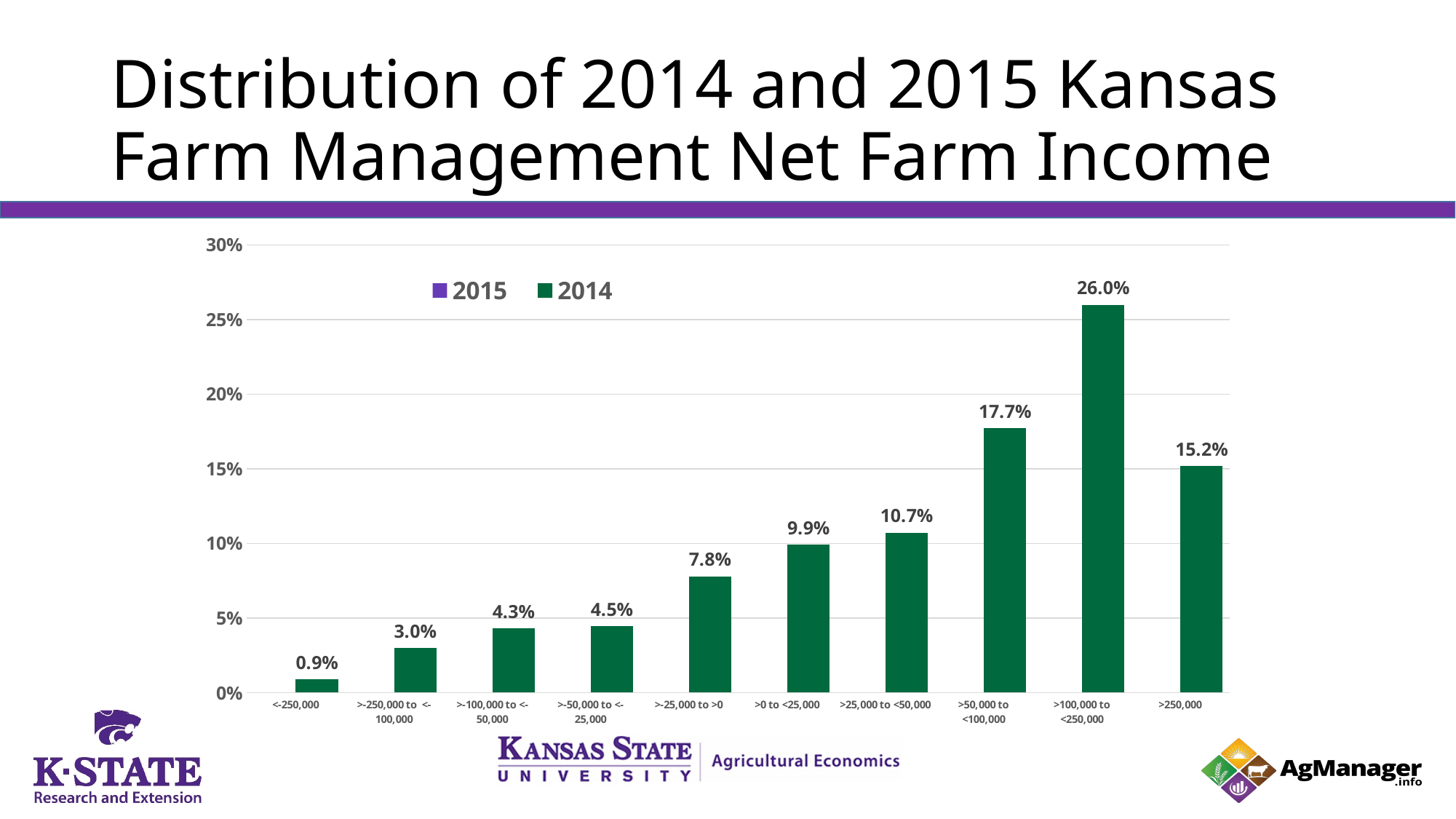
What is the 2014 value for the >0 to <25,000 category? 9.9% Which net farm income category has the lowest 2014 value? <-250,000 What kind of chart is shown on the slide? Bar chart Is the 2014 value for the >25,000 to <50,000 category greater or less than 10%? greater Which net farm income category has the highest 2014 value? >100,000 to <250,000 What is the 2014 value for the <-250,000 category? 0.9% What is the difference between the 2014 values for the >100,000 to <250,000 and >50,000 to <100,000 categories? 8.3% What is the 2014 value for the >250,000 category? 15.2% How many series does the legend list? 2 Which has a larger 2014 value: the >250,000 category or the >50,000 to <100,000 category? >50,000 to <100,000 How many net farm income categories are shown on the x axis? 10 What is the 2014 value for the >100,000 to <250,000 net farm income category? 26.0%